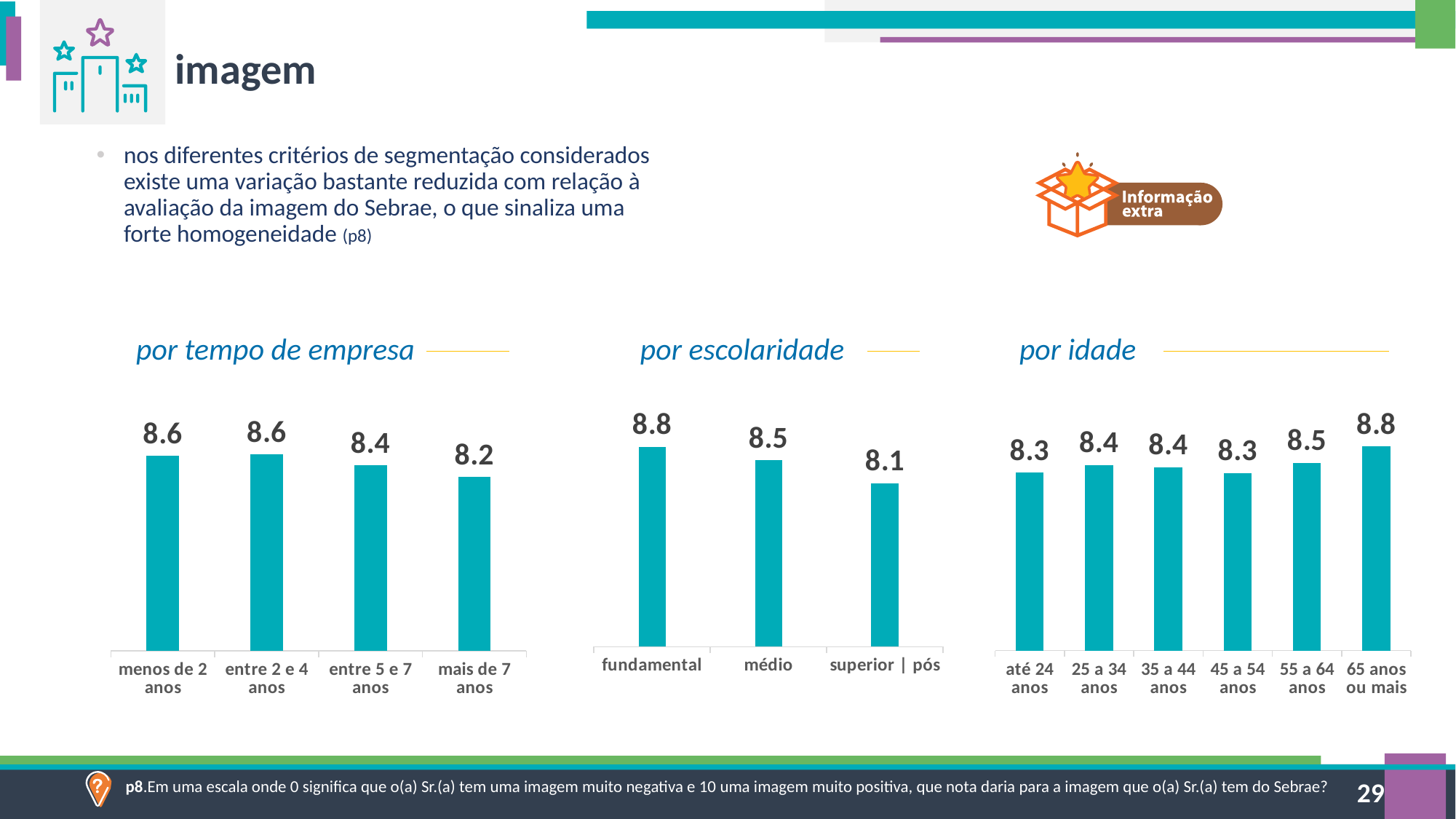
In the 'por escolaridade' chart, what is the difference between 'fundamental' and 'superior | pós'? 0.7 In the 'por escolaridade' chart, what is the value for 'médio'? 8.5 What type of chart is the 'por tempo de empresa' chart? bar chart In the 'por tempo de empresa' chart, what is the value for 'mais de 7 anos'? 8.2 In the 'por escolaridade' chart, which category has the highest value? fundamental In the 'por tempo de empresa' chart, how many categories are shown? 4 In the 'por idade' chart, how many age categories are shown? 6 In the 'por idade' chart, which category has the highest value? 65 anos ou mais In the 'por idade' chart, what is the value for '55 a 64 anos'? 8.5 In the 'por tempo de empresa' chart, what is the difference between 'menos de 2 anos' and 'mais de 7 anos'? 0.4 In the 'por idade' chart, which is larger: the value for '25 a 34 anos' or '45 a 54 anos'? 25 a 34 anos In the 'por escolaridade' chart, which category has the lowest value? superior | pós